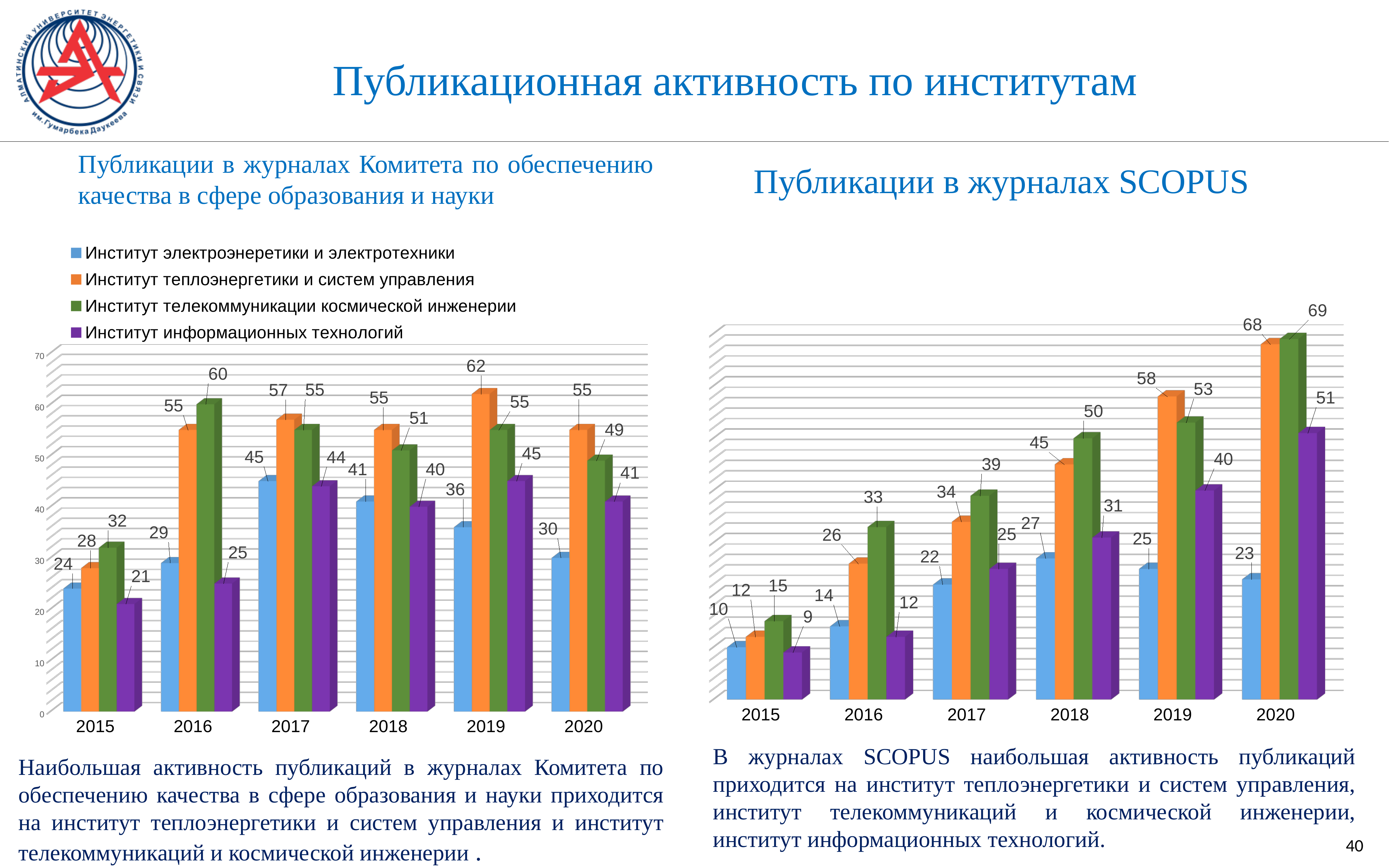
In the chart 'Публикации в журналах SCOPUS', which institute has the lowest value in 2015? Институт информационных технологий How many years are shown on the x axis of the chart 'Публикации в журналах SCOPUS'? 6 How many series does the legend on the slide list? 4 In the chart 'Публикации в журналах Комитета по обеспечению качества в сфере образования и науки', what is the difference between Институт теплоэнергетики и систем управления and Институт электроэнеретики и электротехники in 2019? 26 In the chart 'Публикации в журналах SCOPUS', what is the value for Институт теплоэнергетики и систем управления in 2020? 68 In the chart 'Публикации в журналах Комитета по обеспечению качества в сфере образования и науки', what is the value for Институт телекоммуникации космической инженерии in 2016? 60 In the chart 'Публикации в журналах SCOPUS', which institute has the highest value in 2020? Институт телекоммуникации космической инженерии In the chart 'Публикации в журналах SCOPUS', which is larger in 2019: Институт теплоэнергетики и систем управления or Институт телекоммуникации космической инженерии? Институт теплоэнергетики и систем управления In the chart 'Публикации в журналах Комитета по обеспечению качества в сфере образования и науки', what is the value for Институт информационных технологий in 2015? 21 In the chart 'Публикации в журналах SCOPUS', do the values for Институт информационных технологий rise or fall from 2015 to 2020? rise What kind of chart is 'Публикации в журналах SCOPUS'? bar chart In the chart 'Публикации в журналах Комитета по обеспечению качества в сфере образования и науки', is the value for Институт теплоэнергетики и систем управления in 2019 greater or less than 60? greater